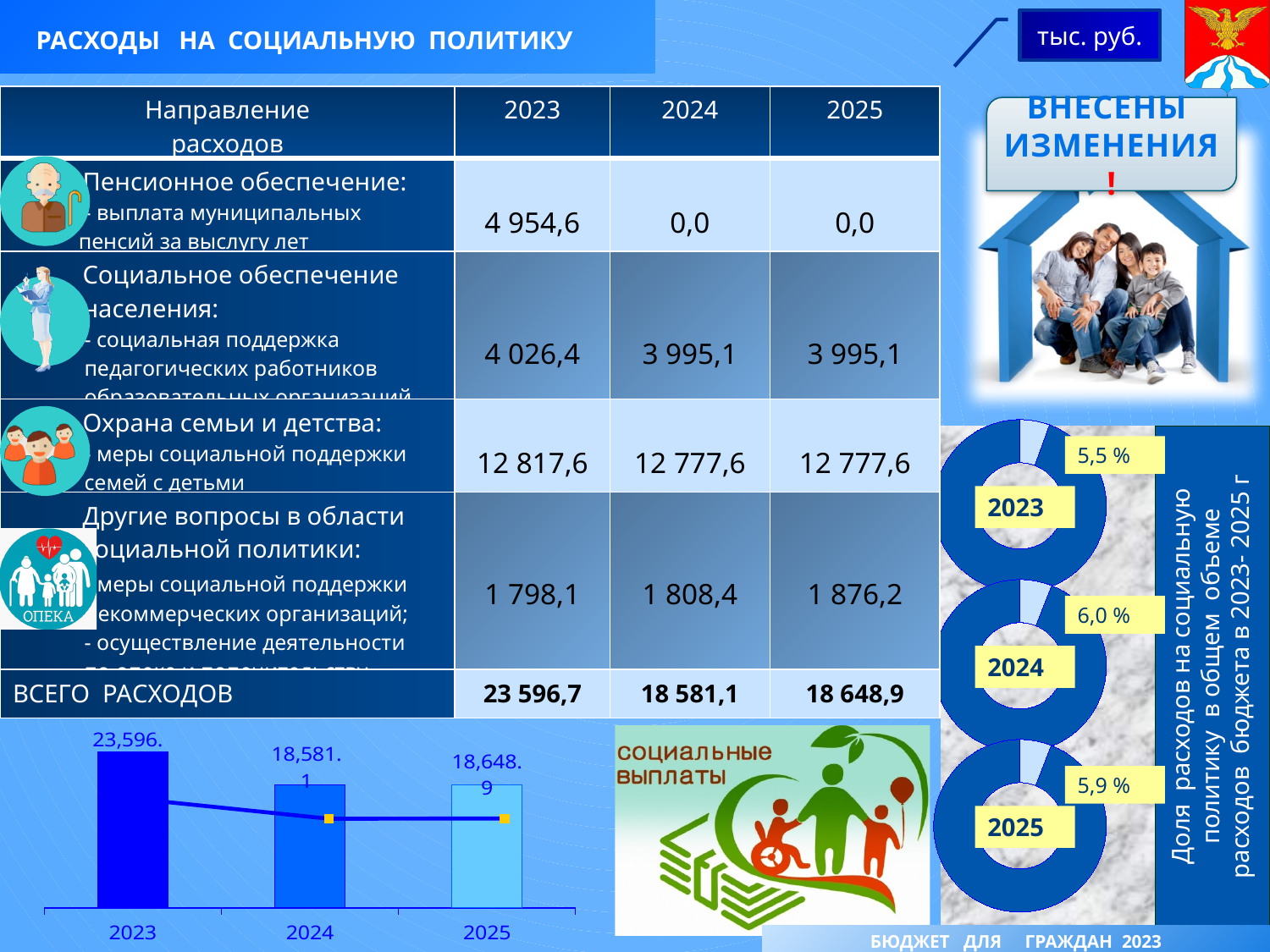
In the bar chart at the bottom left, does the value rise or fall from 2023 to 2024? fall In the ring charts on the right of the slide, what share is shown for 2024? 6,0 % In the bar chart at the bottom left, what is the difference between the 2025 value and the 2024 value? 67.8 In the ring charts on the right of the slide, which year has the highest share? 2024 In the ring charts on the right of the slide, what share is shown for 2023? 5,5 % In the bar chart at the bottom left, which is larger, the value for 2024 or the value for 2025? 2025 What kind of chart is shown at the bottom left of the slide? bar chart In the bar chart at the bottom left, how many years are plotted on the x axis? 3 In the bar chart at the bottom left, what is the value labelled for 2025? 18,648.9 In the bar chart at the bottom left, which year has the highest bar? 2023 In the bar chart at the bottom left, what is the value labelled for 2024? 18,581.1 In the bar chart at the bottom left, which year has the lowest bar? 2024